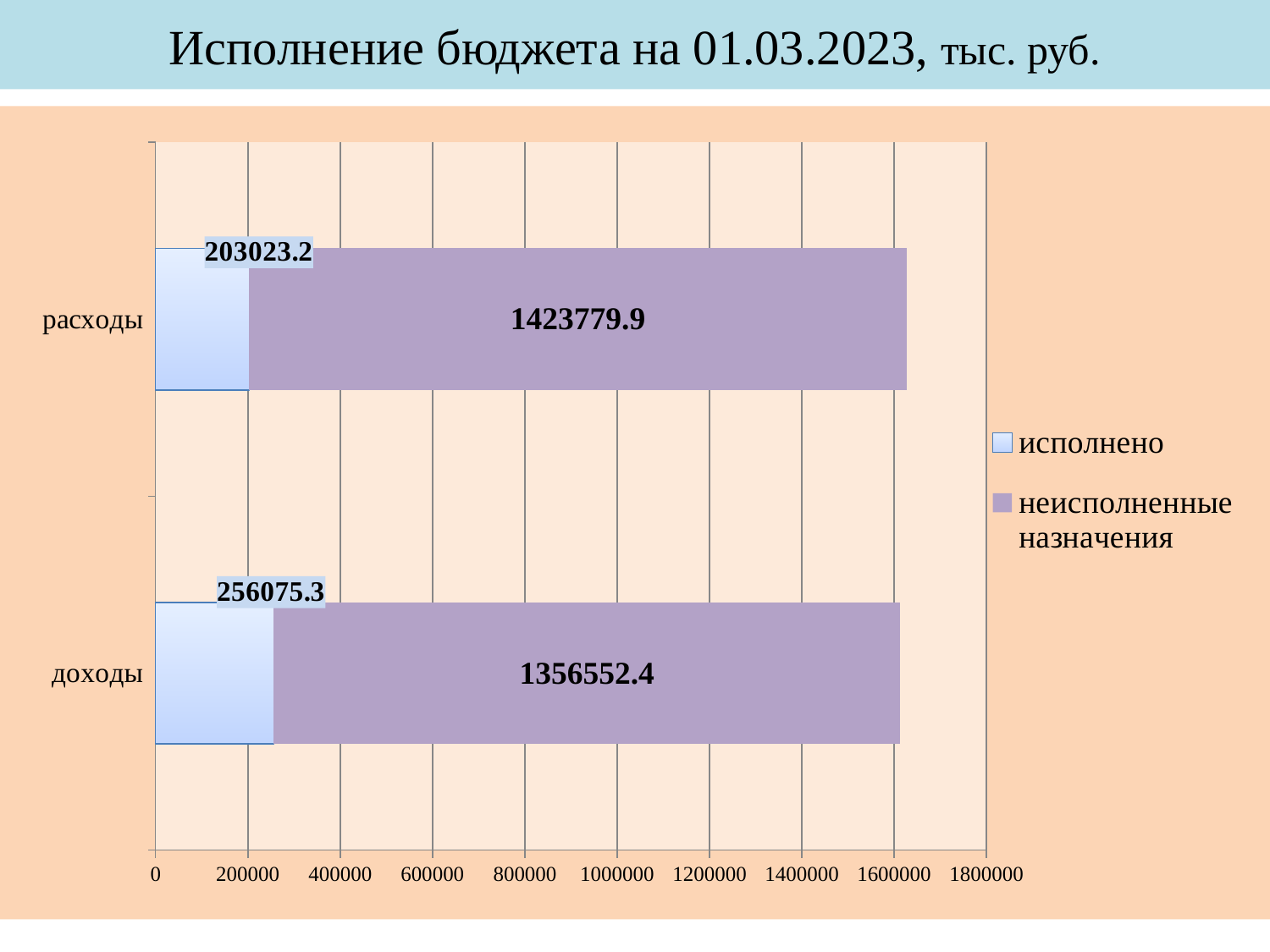
What is the value of 'исполнено' for 'расходы'? 203023.2 What is the value of 'исполнено' for 'доходы'? 256075.3 How many series does the legend list? 2 What is the difference between the 'исполнено' values for 'доходы' and 'расходы'? 53052.1 What is the value of 'неисполненные назначения' for 'расходы'? 1423779.9 What type of chart is shown on the slide? Stacked bar chart What is the value of 'неисполненные назначения' for 'доходы'? 1356552.4 Which category has the higher 'неисполненные назначения' value? расходы What is the total of the stacked bar for 'расходы'? 1626803.1 What is the title of the chart? Исполнение бюджета на 01.03.2023, тыс. руб. Which category has the higher 'исполнено' value, 'расходы' or 'доходы'? доходы What is the total of the stacked bar for 'доходы'? 1612627.7